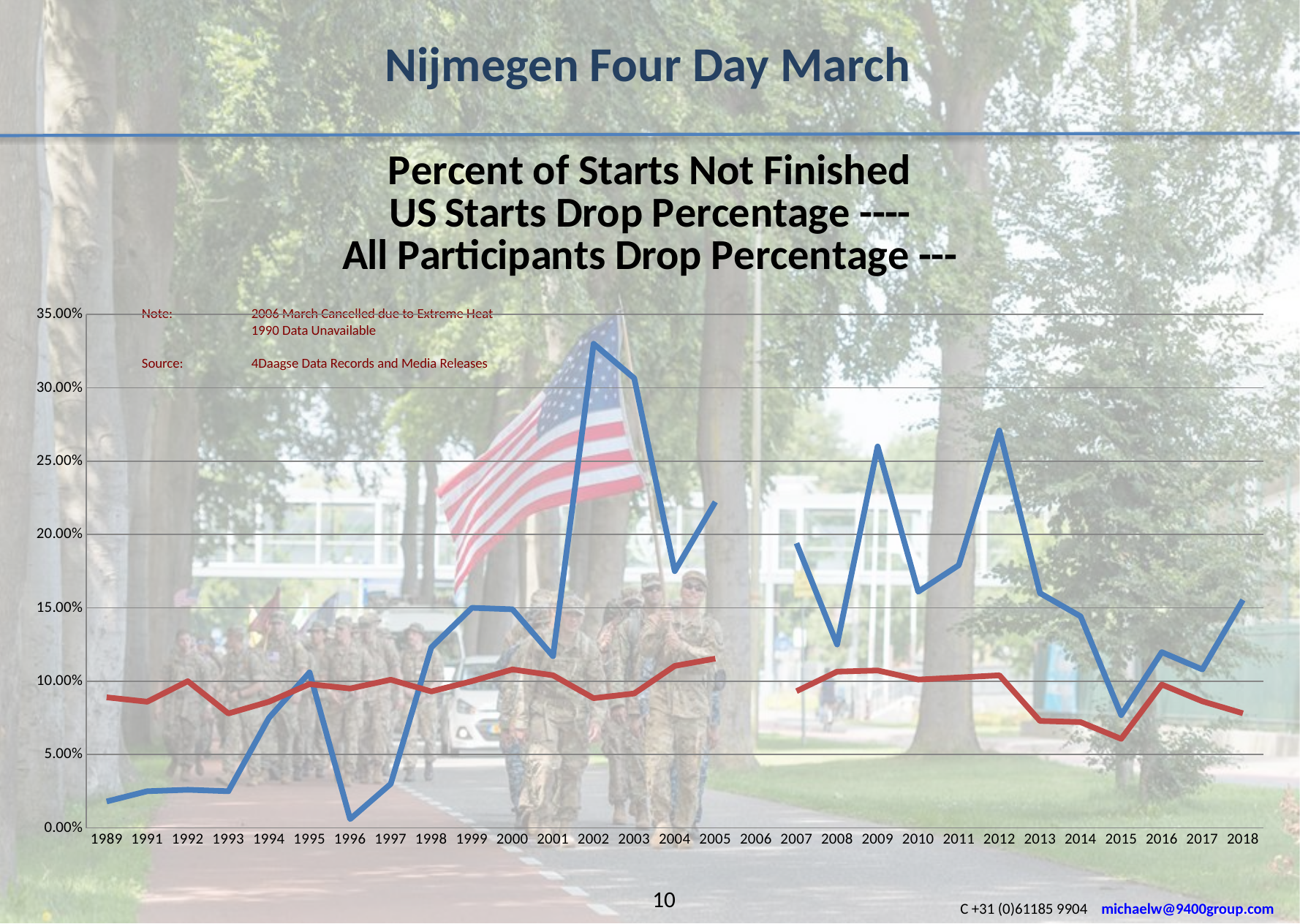
In which year is the All Participants Drop Percentage at its lowest? 2015 Is the All Participants Drop Percentage for 2015 greater or less than 10.00%? less How many data series does the chart plot? 2 What kind of chart is shown on the slide? line chart In which year is the US Starts Drop Percentage at its lowest? 1996 Does the US Starts Drop Percentage rise or fall from 1996 to 2002? rise Is the US Starts Drop Percentage for 1996 greater or less than 5.00%? less Which colour line represents the US Starts Drop Percentage? blue Is the US Starts Drop Percentage for 2002 greater or less than 30.00%? greater In 1996, which is larger: the US Starts Drop Percentage or the All Participants Drop Percentage? All Participants Drop Percentage In 2002, which is larger: the US Starts Drop Percentage or the All Participants Drop Percentage? US Starts Drop Percentage In which year does the US Starts Drop Percentage reach its highest value? 2002